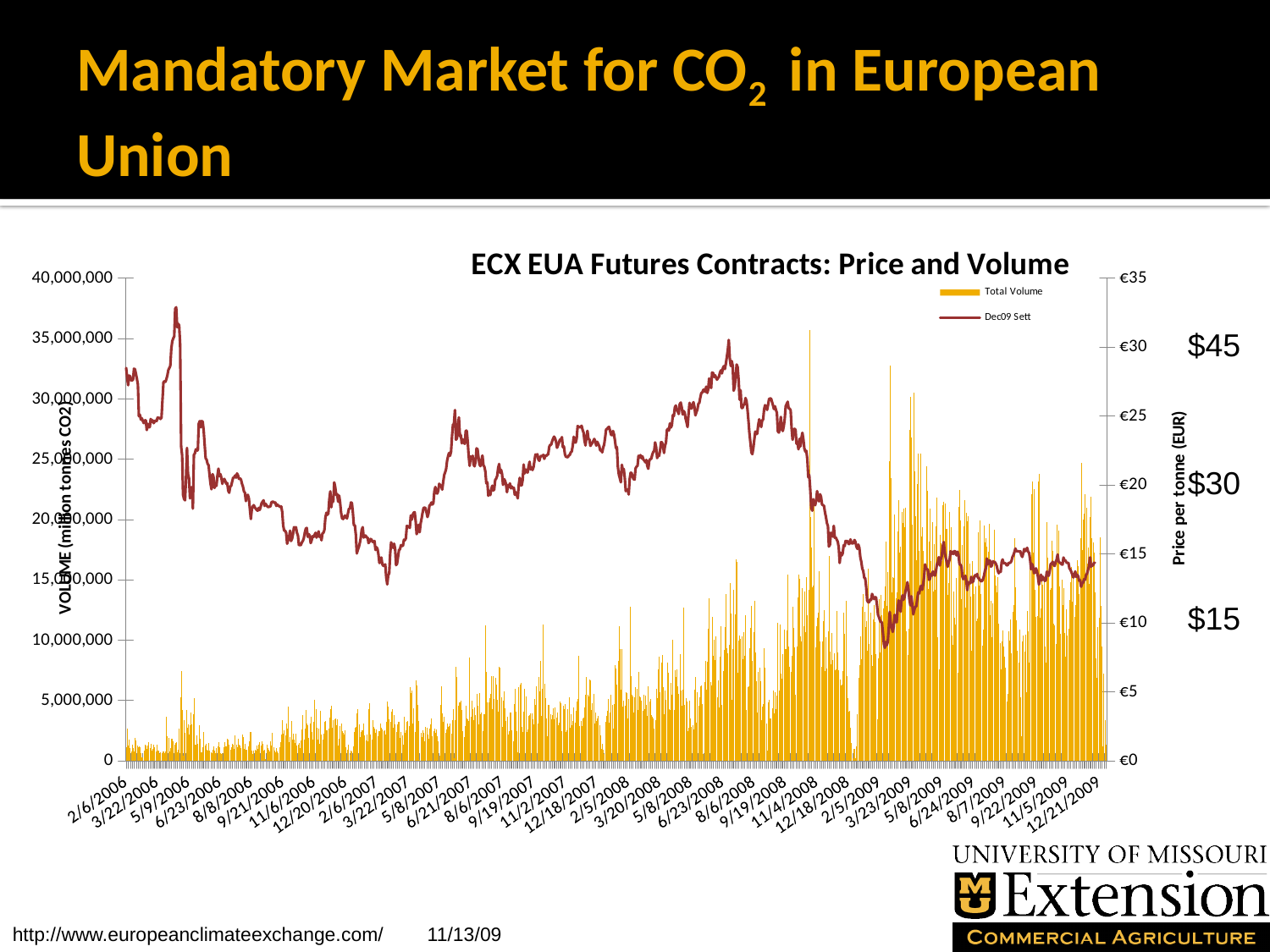
Overall, does the Dec09 Sett price rise or fall from 2/6/2006 to 12/21/2009? fall What is the highest value shown on the right-hand price axis? €35 How many series does the chart's legend list? 2 What kind of chart is shown on the slide? A combined bar and line chart Is the Dec09 Sett price at the end of the chart (12/21/2009) greater or less than €20? less Is the highest Total Volume bar on the chart greater or less than 30,000,000? greater Which series is drawn as bars, Total Volume or Dec09 Sett? Total Volume What is the title of the chart on the slide? ECX EUA Futures Contracts: Price and Volume What are the two series named in the chart's legend? Total Volume and Dec09 Sett Is the Dec09 Sett price at the start of the chart (2/6/2006) greater or less than €25? greater Overall, does Total Volume rise or fall from 2006 to 2009? rise